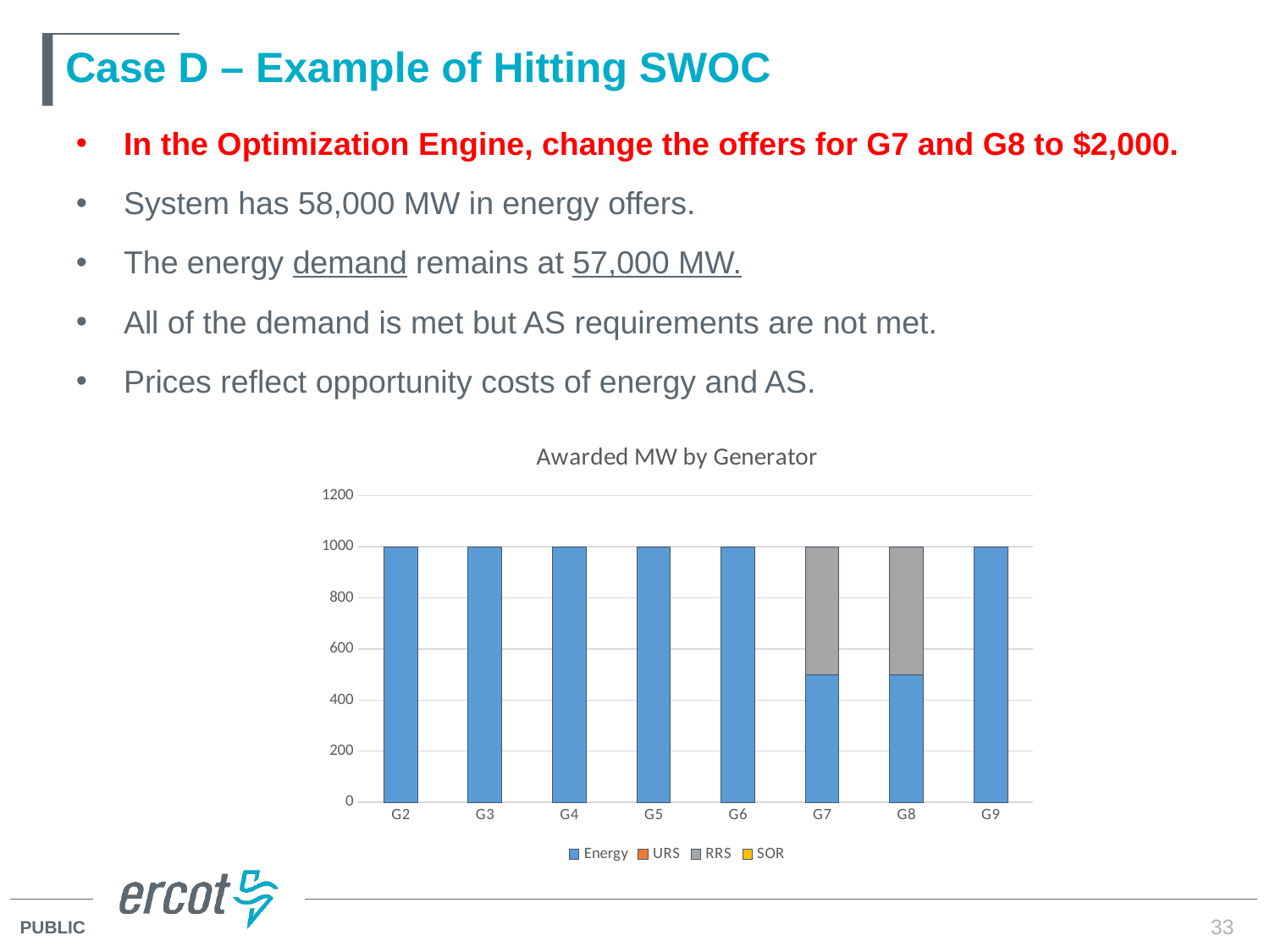
What kind of chart is shown on the slide? Stacked bar chart Which generators have an RRS award shown in the chart? G7 and G8 What is the title of the chart? Awarded MW by Generator How many series does the chart legend list? 4 Which series are listed in the chart legend? Energy, URS, RRS, SOR What is the total height of the stacked bar for G7? 1000 Is the Energy value for G8 greater or less than 400? greater How many generators are shown on the x axis of the chart? 8 Which is larger, the Energy value for G6 or the Energy value for G7? G6 Is the Energy value for G7 greater or less than 600? less Is the Energy value for G9 greater or less than 800? greater What is the total awarded MW for G2? 1000